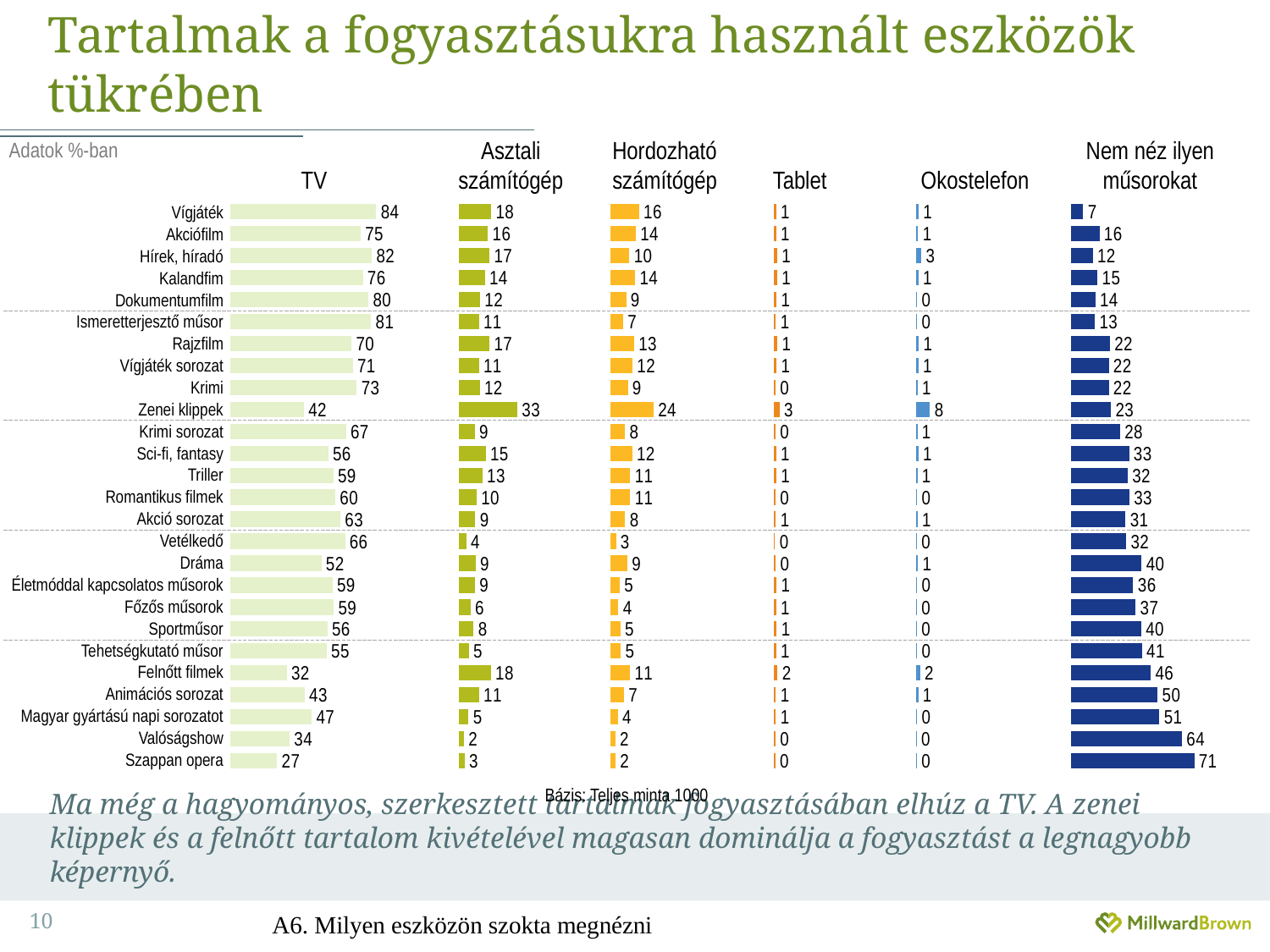
In the Nem néz ilyen műsorokat chart, what is the value for Szappan opera? 71 In the TV chart, which category has the highest value? Vígjáték In the TV chart, what is the difference between the values for Vígjáték and Szappan opera? 57 In the TV chart, which category has the lowest value? Szappan opera In the Hordozható számítógép chart, which category has the highest value? Zenei klippek How many categories are shown in the TV chart? 26 In the TV chart, which is larger: the value for Rajzfilm or the value for Krimi? Krimi In the Nem néz ilyen műsorokat chart, which category has the lowest value? Vígjáték What kind of chart is the TV chart? bar chart In the Okostelefon chart, what is the value for Zenei klippek? 8 In the TV chart, what is the value for Vígjáték? 84 In the Asztali számítógép chart, what is the value for Zenei klippek? 33